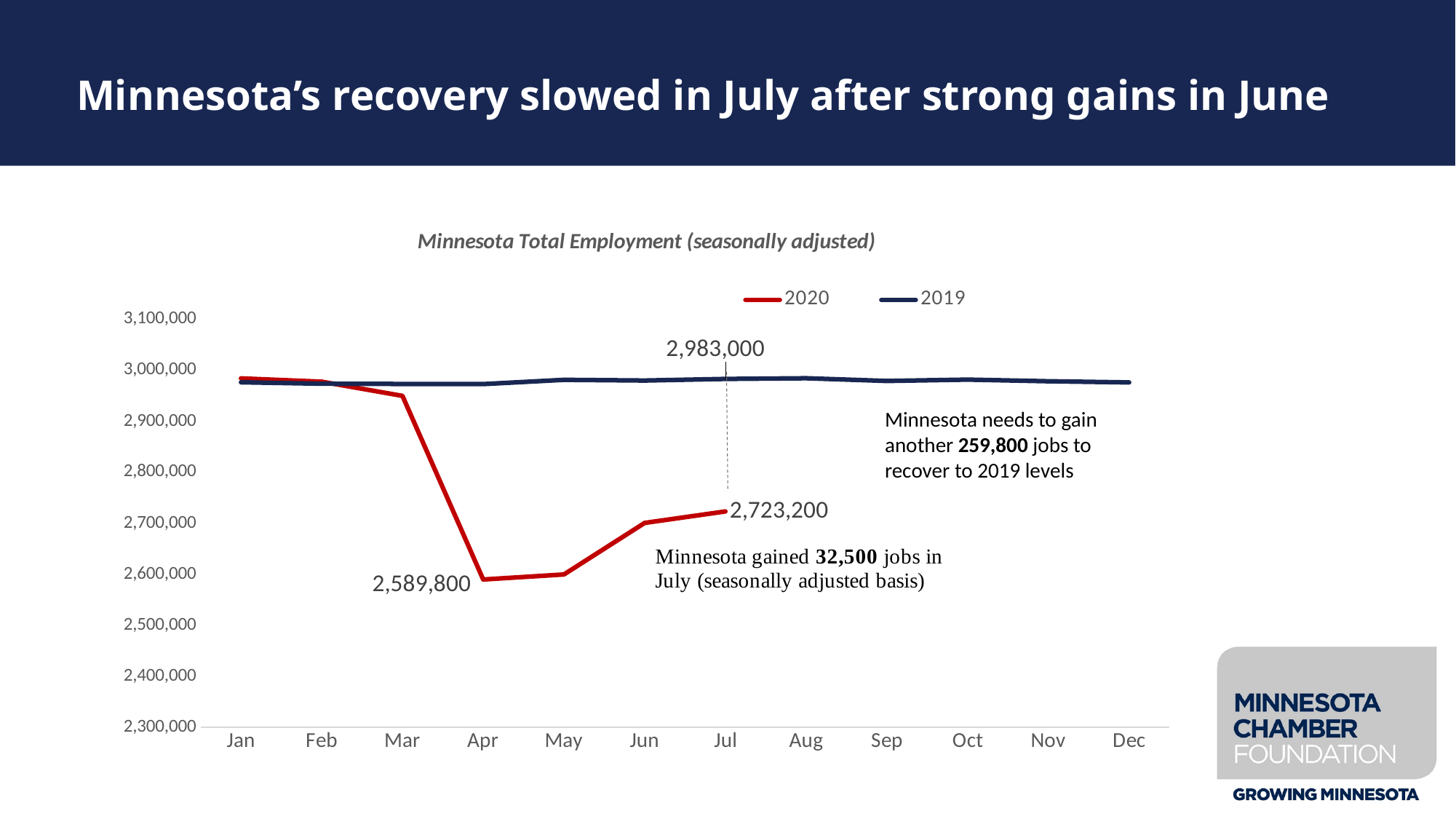
What is the difference between the 2019 and 2020 values for Jul? 259,800 Does the 2020 line rise or fall from Apr to Jul? rise How many months are shown on the x axis? 12 In which month does the 2020 line reach its lowest point? Apr How many series does the legend list? 2 Which series has the higher value in Jul, 2019 or 2020? 2019 Is the 2020 value for Jun greater or less than 2,800,000? less What is the 2019 value for Jul on the chart? 2,983,000 What kind of chart is shown on the slide? line chart What is the 2020 value for Jul on the Minnesota Total Employment chart? 2,723,200 What is the 2020 value for Apr on the chart? 2,589,800 Is the 2020 value for Mar greater or less than 2,900,000? greater